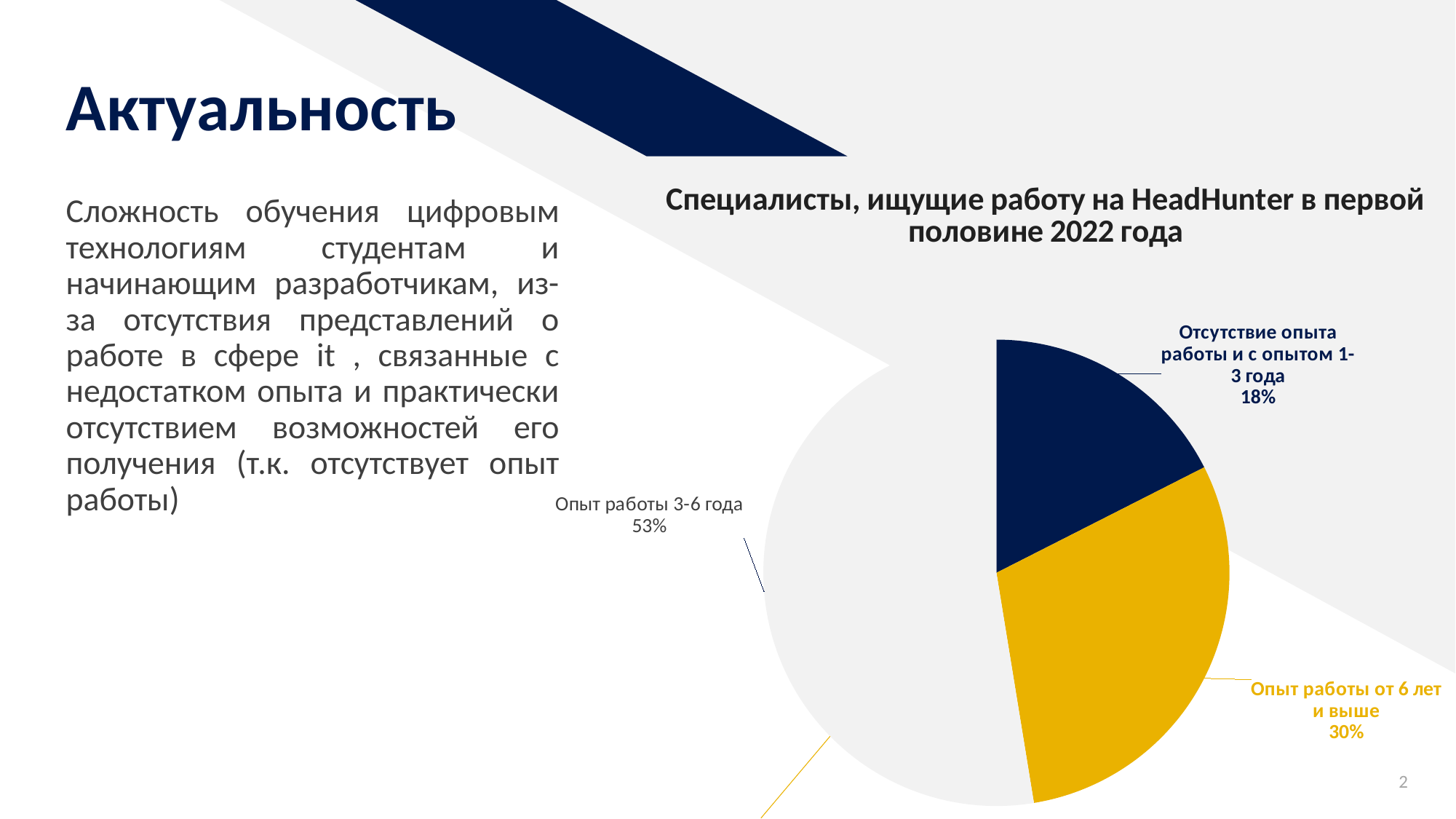
What colour is the slice for "Опыт работы от 6 лет и выше"? yellow What share of the pie is labelled "Отсутствие опыта работы и с опытом 1-3 года"? 18% Which category has the largest slice of the pie? Опыт работы 3-6 года What is the difference in percentage points between "Опыт работы 3-6 года" and "Опыт работы от 6 лет и выше"? 23 Which is larger: the slice for "Опыт работы от 6 лет и выше" or the slice for "Отсутствие опыта работы и с опытом 1-3 года"? Опыт работы от 6 лет и выше What kind of chart is shown on the slide? pie chart How many slices does the pie chart have? 3 What share of the pie is labelled "Опыт работы от 6 лет и выше"? 30% What share of the pie is labelled "Опыт работы 3-6 года"? 53% What is the difference in percentage points between "Опыт работы от 6 лет и выше" and "Отсутствие опыта работы и с опытом 1-3 года"? 12 Which category has the smallest slice of the pie? Отсутствие опыта работы и с опытом 1-3 года What is the title of the chart? Специалисты, ищущие работу на HeadHunter в первой половине 2022 года